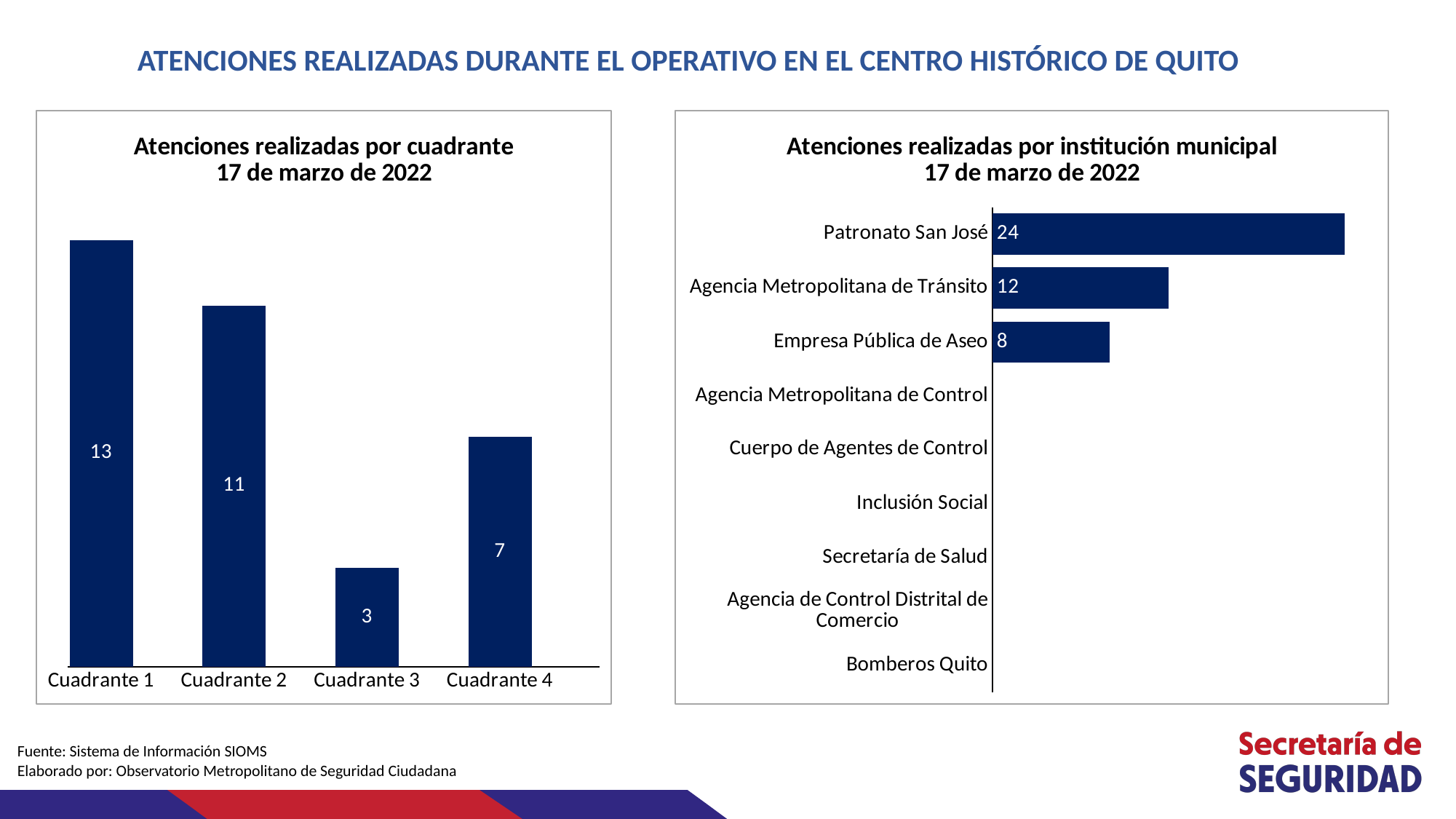
In the chart 'Atenciones realizadas por cuadrante', what is the difference between Cuadrante 1 and Cuadrante 4? 6 In the chart 'Atenciones realizadas por institución municipal', what is the value for Empresa Pública de Aseo? 8 In the chart 'Atenciones realizadas por institución municipal', what is the difference between Patronato San José and Empresa Pública de Aseo? 16 In the chart 'Atenciones realizadas por institución municipal', what is the value for Agencia Metropolitana de Tránsito? 12 In the chart 'Atenciones realizadas por cuadrante', what is the value for Cuadrante 2? 11 In the chart 'Atenciones realizadas por cuadrante', which cuadrante has the highest value? Cuadrante 1 In the chart 'Atenciones realizadas por cuadrante', which cuadrante has the lowest value? Cuadrante 3 In the chart 'Atenciones realizadas por institución municipal', which institution has the highest value? Patronato San José In the chart 'Atenciones realizadas por cuadrante', which is larger, Cuadrante 3 or Cuadrante 4? Cuadrante 4 In the chart 'Atenciones realizadas por cuadrante', how many cuadrantes are shown? 4 In the chart 'Atenciones realizadas por institución municipal', how many institutions are listed on the axis? 9 What kind of chart is 'Atenciones realizadas por cuadrante'? Bar chart